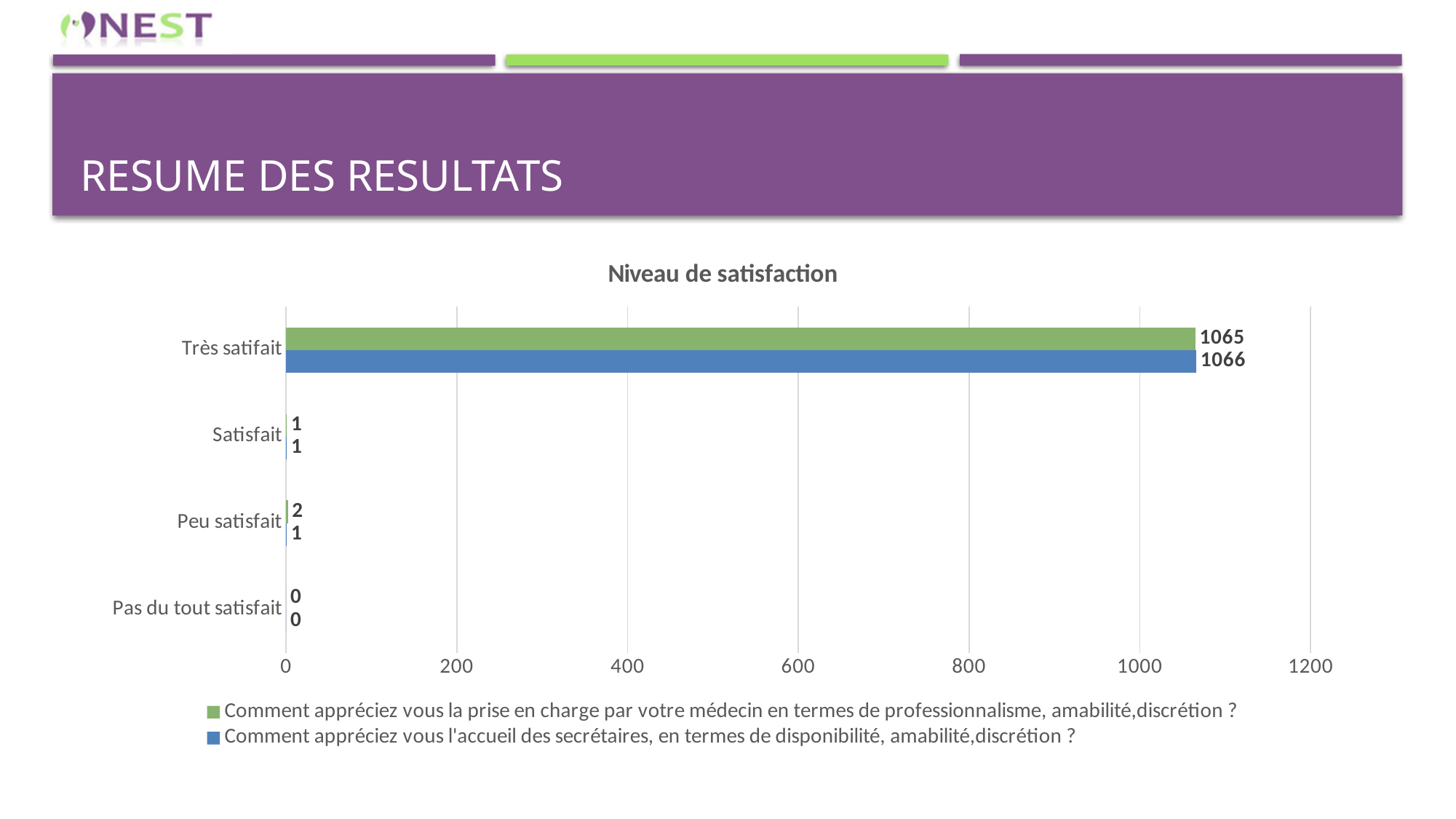
How many series does the legend list? 2 What is the value for 'Pas du tout satisfait' in the series about the secrétaires (blue)? 0 Which category has the lowest value in the series about the médecin (green)? Pas du tout satisfait What is the value for 'Très satifait' in the series about the médecin (green)? 1065 What is the title of the chart? Niveau de satisfaction Is the value for 'Très satifait' in the médecin (green) series greater or less than 1000? greater Which category has the highest value in the series about the secrétaires (blue)? Très satifait What is the difference between the 'Très satifait' values of the secrétaires series (1066) and the médecin series (1065)? 1 What is the value for 'Peu satisfait' in the series about the médecin (green)? 2 How many satisfaction categories are shown on the chart? 4 What type of chart is shown on the slide? bar chart What is the value for 'Très satifait' in the series about the secrétaires (blue)? 1066